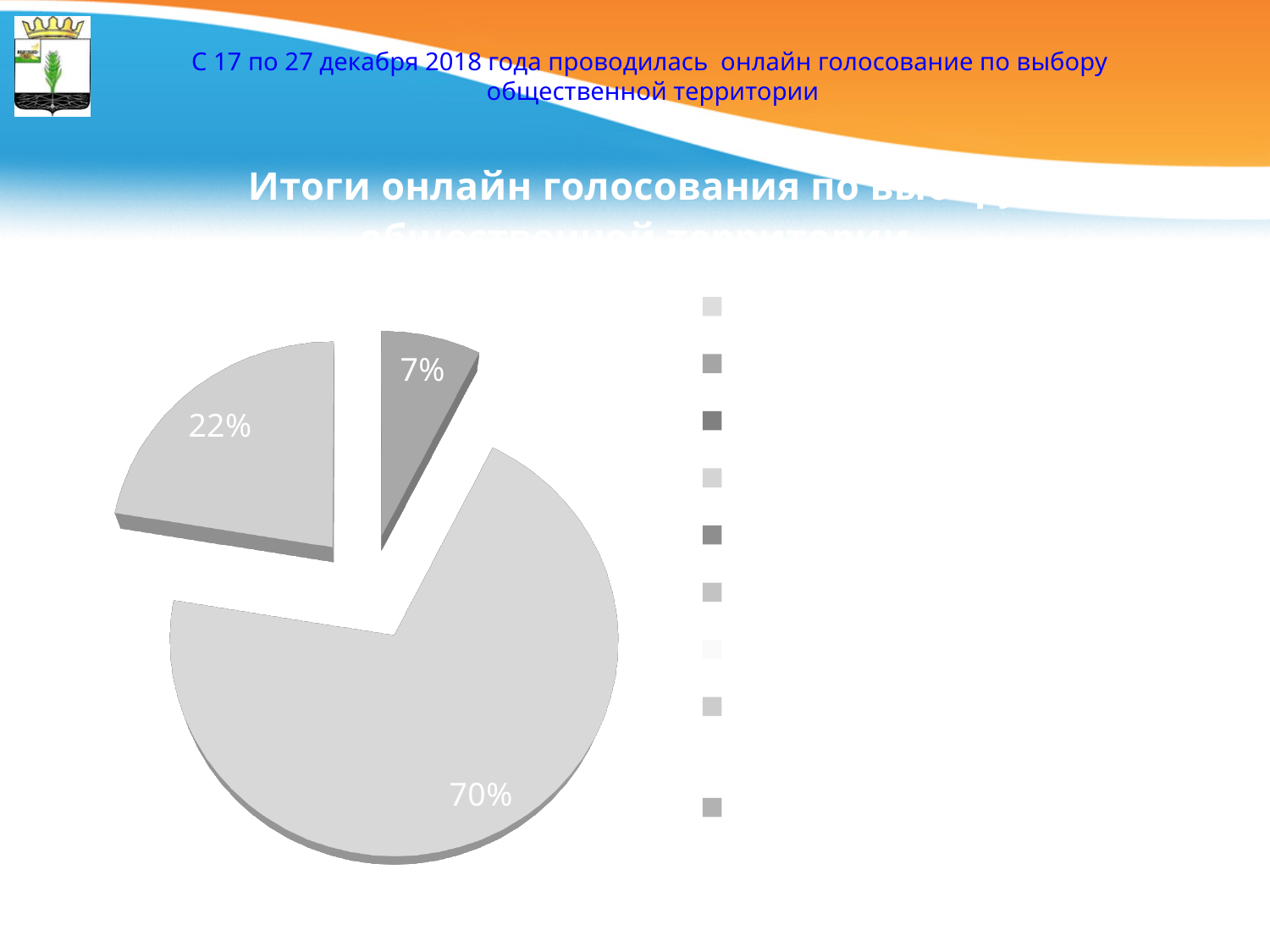
What is the difference between the largest slice (70%) and the slice labelled 22%? 48 percentage points What is the value of the largest slice of the pie chart? 70% What kind of chart is shown on the slide? pie chart Which is larger, the slice labelled 22% or the slice labelled 7%? the slice labelled 22% What share of the pie does the largest slice represent? 70% On which side of the pie chart is the legend placed? on the right Which slice of the pie chart is drawn in the darkest grey? the 7% slice What is the difference between the slice labelled 22% and the slice labelled 7%? 15 percentage points How many slices of the pie chart have a percentage label? 3 What is the value of the smallest labelled slice of the pie chart? 7% Is the slice labelled 22% greater or less than 25%? less Is the largest slice of the pie chart greater or less than 50%? greater